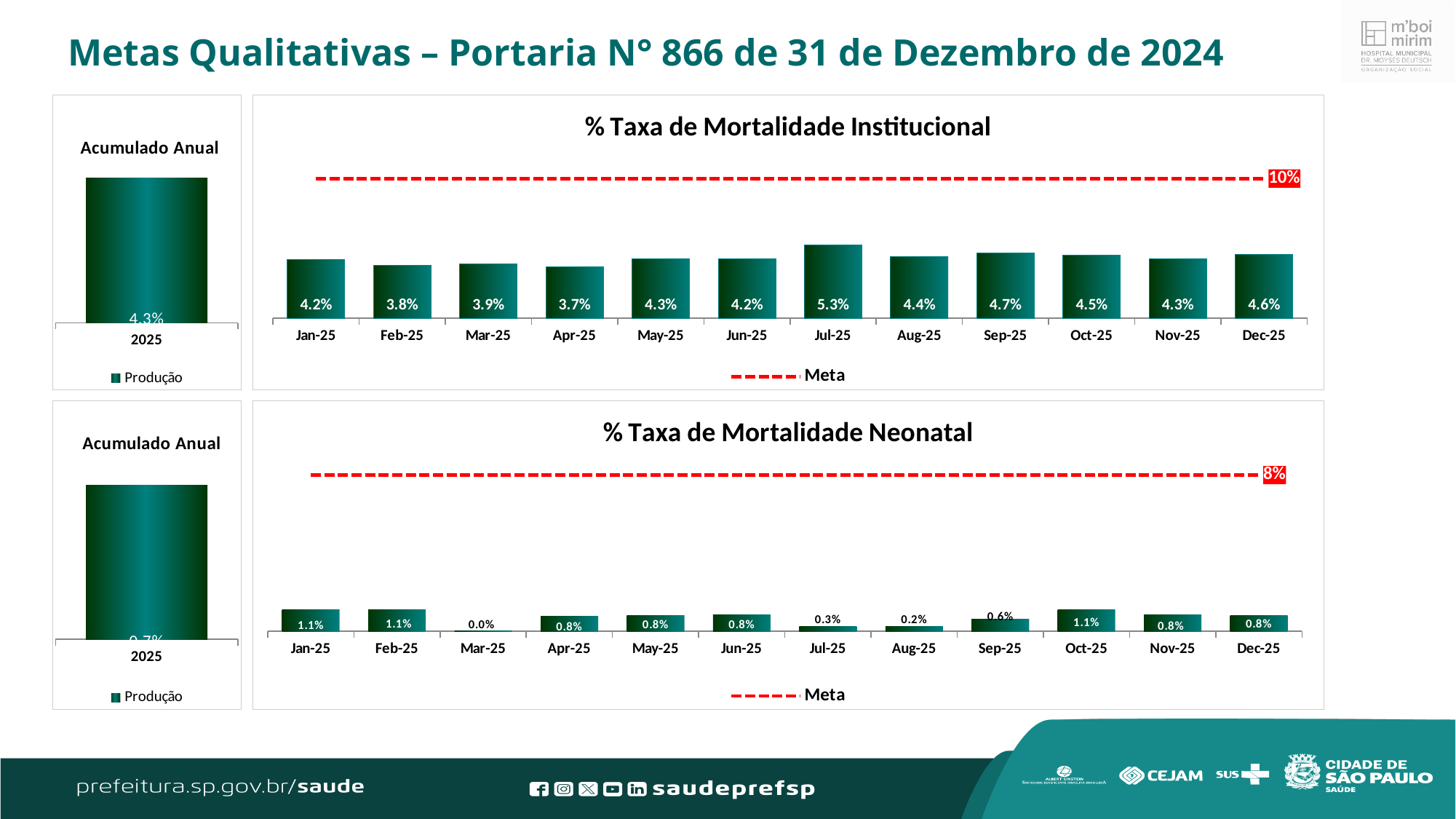
What type of chart is the '% Taxa de Mortalidade Institucional' chart? Combination bar and line chart (bars with a dashed Meta target line) In the '% Taxa de Mortalidade Neonatal' chart, which month has the lowest value? Mar-25 In the '% Taxa de Mortalidade Institucional' chart, what is the value for Jul-25? 5.3% In the '% Taxa de Mortalidade Institucional' chart, what is the difference between the values for Jul-25 and Apr-25? 1.6% In the '% Taxa de Mortalidade Institucional' chart, which month has the lowest value? Apr-25 In the '% Taxa de Mortalidade Institucional' chart, what target value is shown by the dashed Meta line? 10% In the '% Taxa de Mortalidade Neonatal' chart, is the value for Jan-25 or Aug-25 larger? Jan-25 In the '% Taxa de Mortalidade Institucional' chart, which month has the highest value? Jul-25 In the '% Taxa de Mortalidade Neonatal' chart, what target value is shown by the dashed Meta line? 8% In the top-left 'Acumulado Anual' chart, what is the value for 2025? 4.3% In the '% Taxa de Mortalidade Neonatal' chart, what is the value for Mar-25? 0.0% In the '% Taxa de Mortalidade Neonatal' chart, how many months are plotted? 12